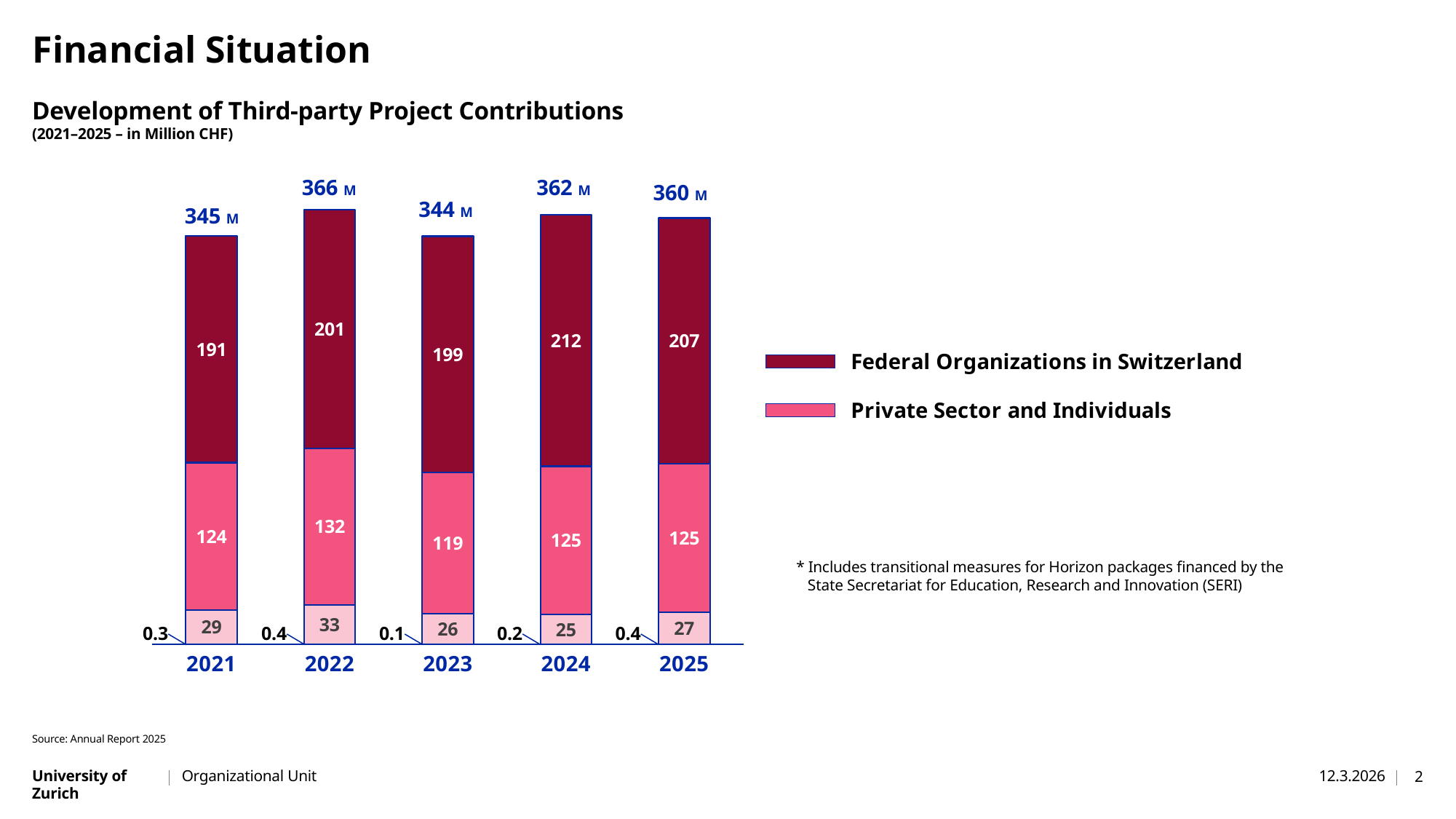
What is the difference between the total for 2022 and the total for 2023? 22 M What kind of chart is shown on the slide? Stacked bar chart Which year has the larger value for Private Sector and Individuals, 2022 or 2023? 2022 What is the value for Federal Organizations in Switzerland in 2024? 212 Which colour represents Federal Organizations in Switzerland in the legend? Dark red How many years are shown on the x axis? 5 Which year has the highest total contribution? 2022 How many series does the legend list? 2 What is the value for Private Sector and Individuals in 2022? 132 Which year has the lowest total contribution? 2023 What is the difference between the Federal Organizations in Switzerland values for 2024 and 2021? 21 What is the total third-party project contribution shown for 2025? 360 M